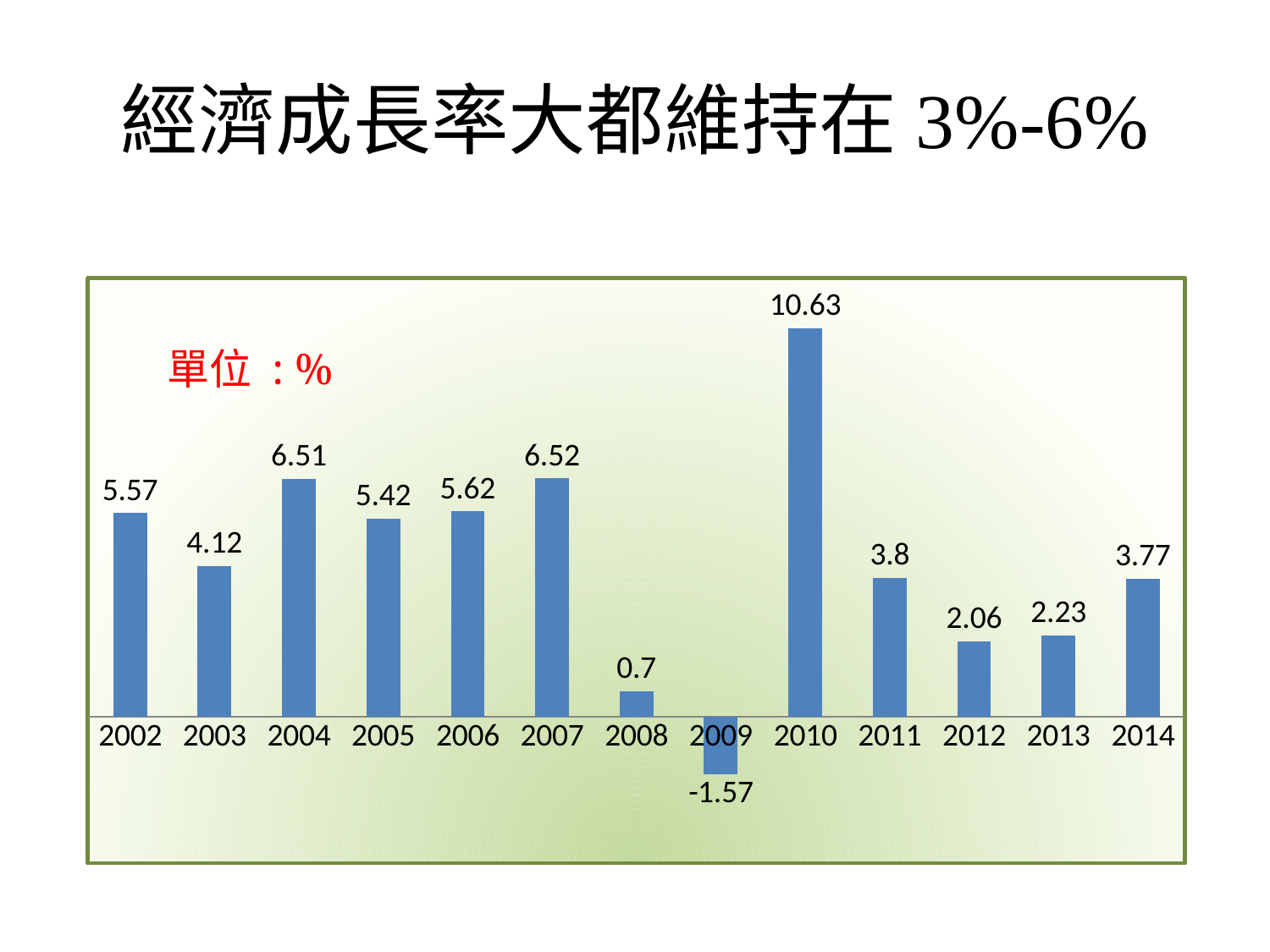
How many years are shown on the x axis? 13 What is the difference between the values for 2010 and 2011? 6.83 Do the values rise or fall from 2011 to 2012? fall Which year has the highest value? 2010 What is the value for 2004? 6.51 Which is larger, the value for 2012 or the value for 2013? 2013 Which year has the lowest value? 2009 What unit is indicated in the red text inside the chart? % What is the difference between the values for 2008 and 2009? 2.27 What is the value for 2009? -1.57 What is the value for 2010? 10.63 What kind of chart is shown on the slide? bar chart